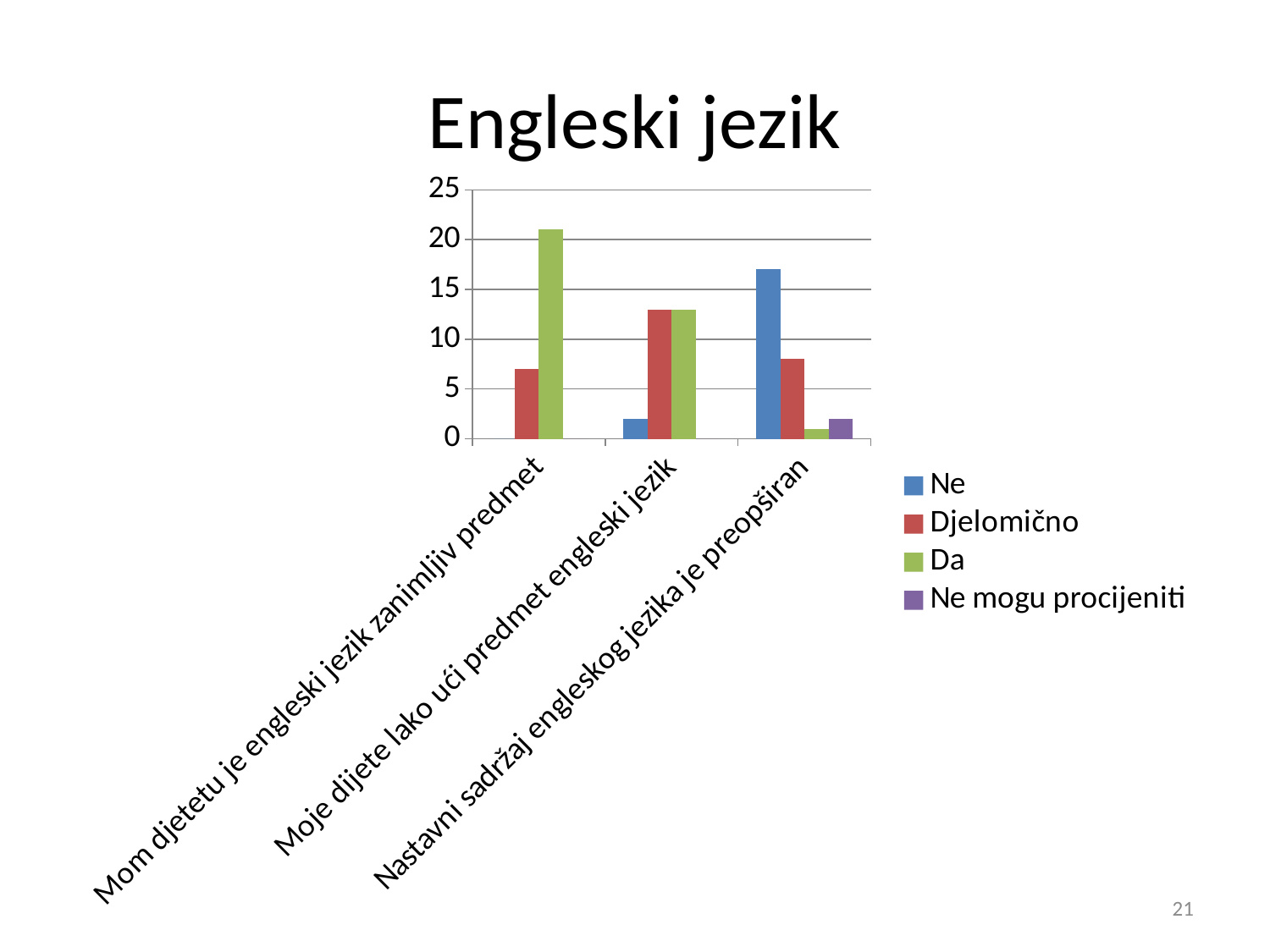
For the category "Mom djetetu je engleski jezik zanimljiv predmet", which series has the highest value? Da Is the value for "Ne" in the category "Moje dijete lako uči predmet engleski jezik" greater or less than 5? less Which colour represents the series "Da" in the legend? green How many categories are shown on the x axis? 3 For the category "Nastavni sadržaj engleskog jezika je preopširan", which series has the highest value? Ne Is the value for "Ne" in the category "Nastavni sadržaj engleskog jezika je preopširan" greater or less than 15? greater What kind of chart is shown on the slide? bar chart In the category "Nastavni sadržaj engleskog jezika je preopširan", which is larger: "Ne" or "Djelomično"? Ne What is the title of the chart? Engleski jezik Is the value for "Da" in the category "Mom djetetu je engleski jezik zanimljiv predmet" greater or less than 15? greater How many series does the legend list? 4